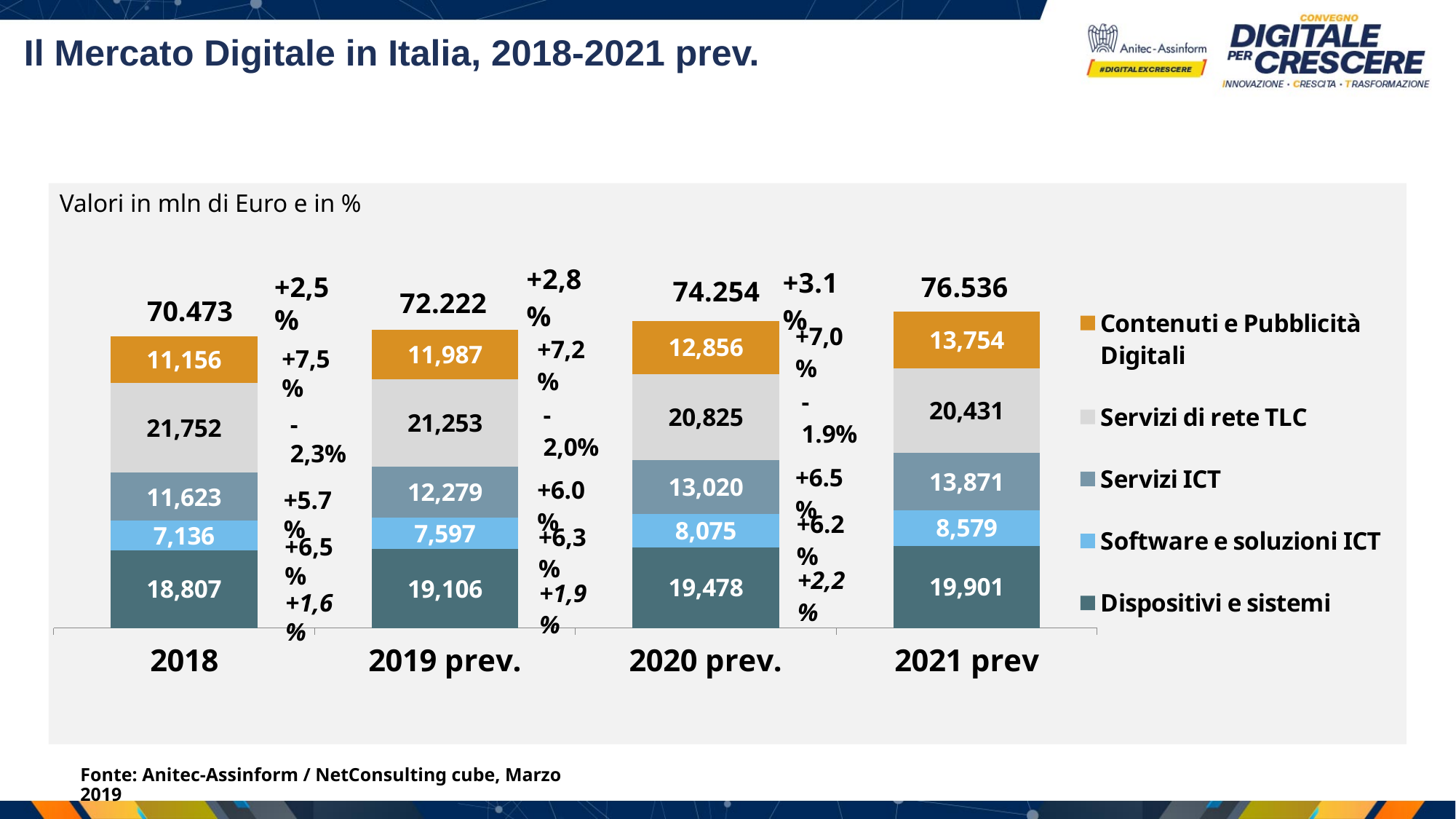
In 2020 prev., which is larger: Servizi ICT or Contenuti e Pubblicità Digitali? Servizi ICT What is the value for Dispositivi e sistemi in 2018? 18,807 Do the values for Servizi di rete TLC rise or fall from 2018 to 2021 prev? fall Which year has the highest total digital market value? 2021 prev How many series does the legend list? 5 What is the total shown above the stacked bar for 2018? 70.473 How many years (categories) are shown on the x axis? 4 What is the value for Software e soluzioni ICT in 2020 prev.? 8,075 What kind of chart is shown on the slide? stacked bar chart What is the value for Servizi di rete TLC in 2021 prev? 20,431 What is the difference between the Servizi ICT value in 2021 prev and in 2018? 2,248 Which segment is the smallest in the 2021 prev bar? Software e soluzioni ICT